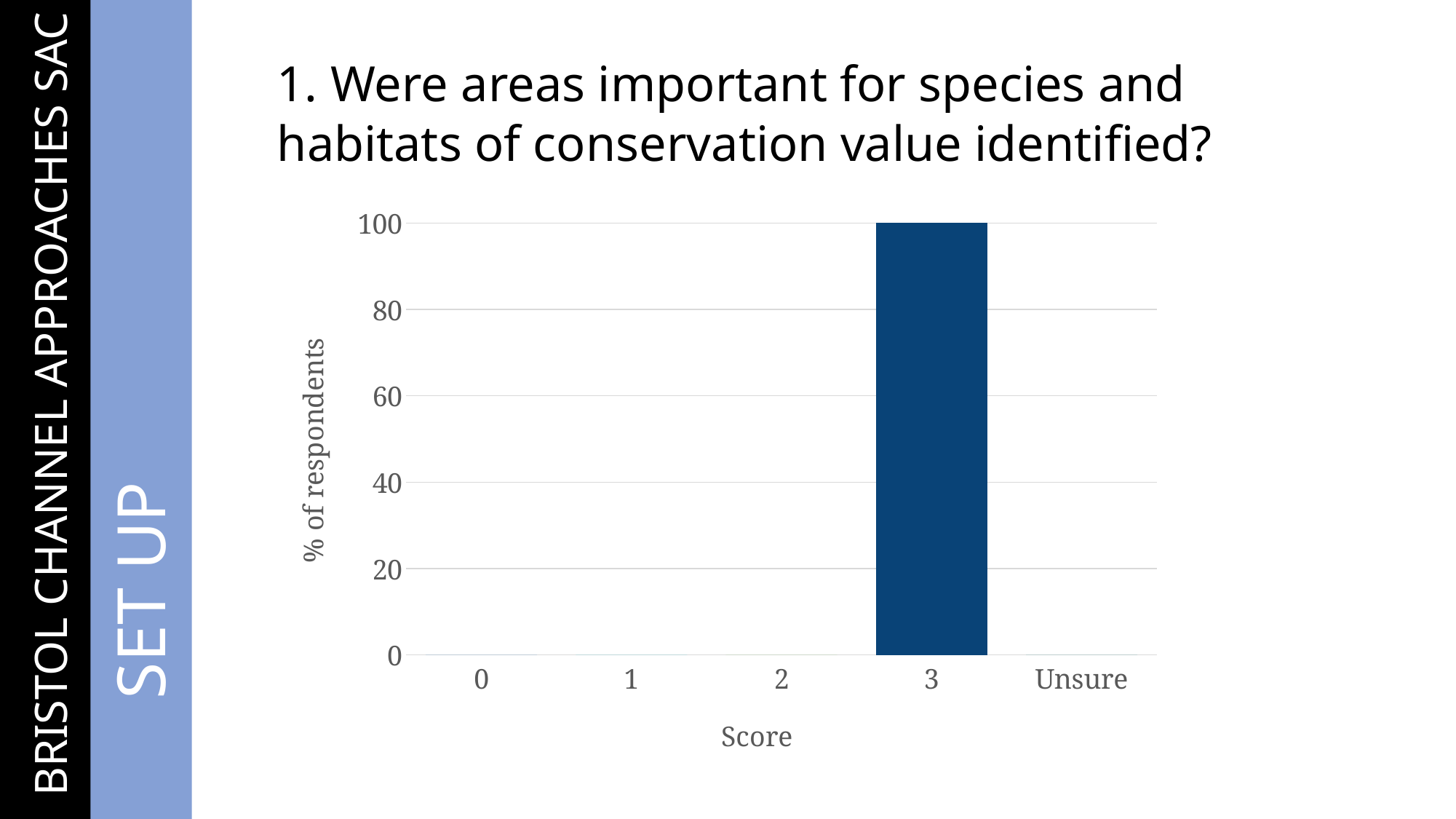
Which is larger, the value for score 3 or the value for score 2? score 3 What type of chart is shown on the slide? bar chart What is the label of the x axis? Score What is the label of the y axis? % of respondents Is the value for score 3 greater or less than 80? greater What is the percentage of respondents for score 0? 0 What is the percentage of respondents for score 3? 100 What is the difference between the value for score 3 and the value for score 1? 100 What is the percentage of respondents for the Unsure category? 0 Which score category has the highest percentage of respondents? 3 How many score categories are shown on the x axis? 5